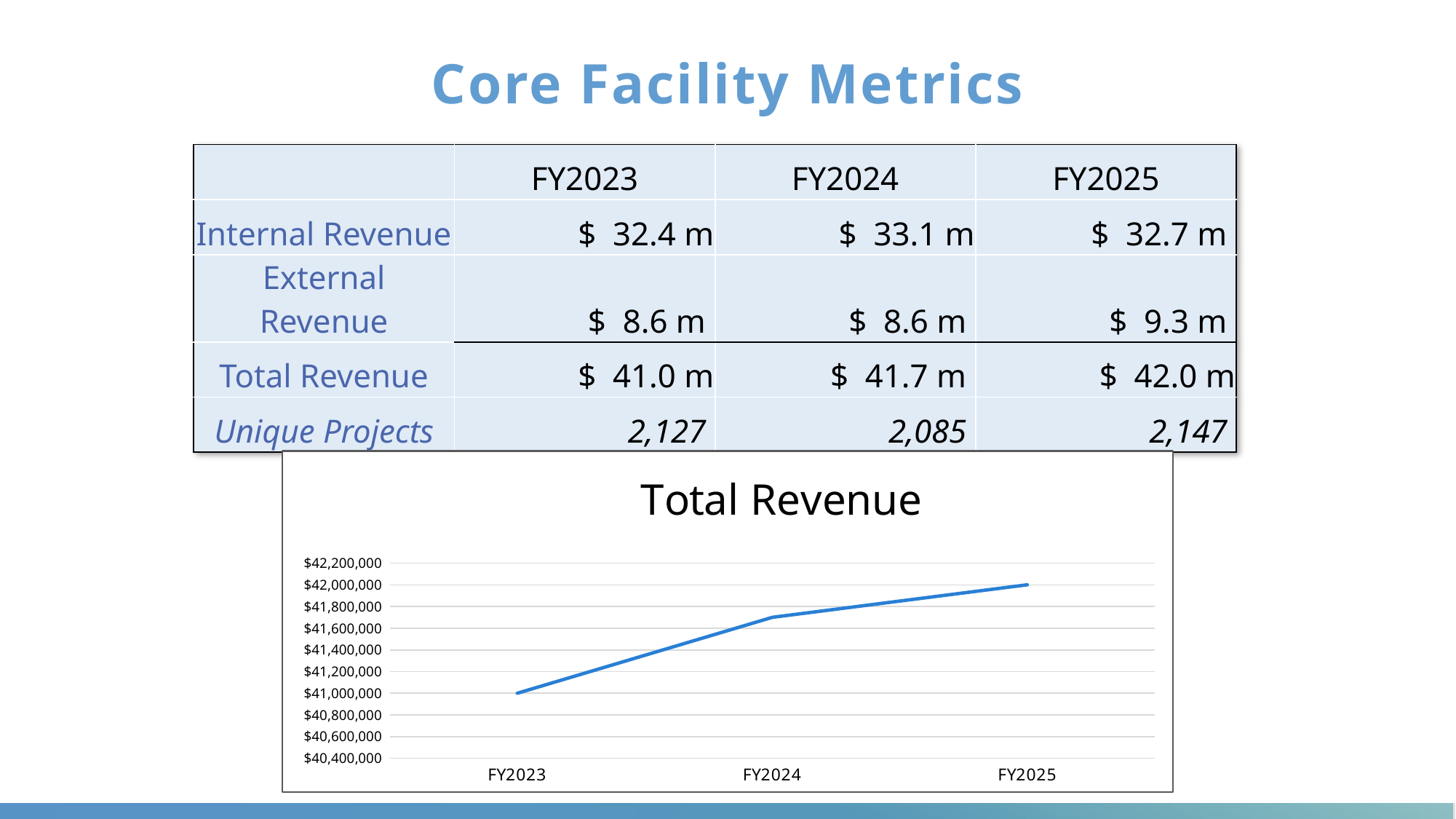
On the Total Revenue chart, what is the difference between the FY2025 value and the FY2023 value? $1,000,000 What kind of chart is shown under the title "Total Revenue"? line chart Which fiscal year has the highest value on the Total Revenue chart? FY2025 On the Total Revenue chart, what is the value for FY2023? $41,000,000 How many fiscal years are plotted on the Total Revenue chart? 3 What is the lowest value shown on the y axis of the Total Revenue chart? $40,400,000 On the Total Revenue chart, which is larger, the value for FY2023 or the value for FY2024? FY2024 Which fiscal year has the lowest value on the Total Revenue chart? FY2023 On the Total Revenue chart, what is the value for FY2025? $42,000,000 On the Total Revenue chart, is the value for FY2024 greater or less than $41,400,000? greater On the Total Revenue chart, is the value for FY2024 greater or less than $42,000,000? less Do the values on the Total Revenue chart rise or fall from FY2023 to FY2025? rise